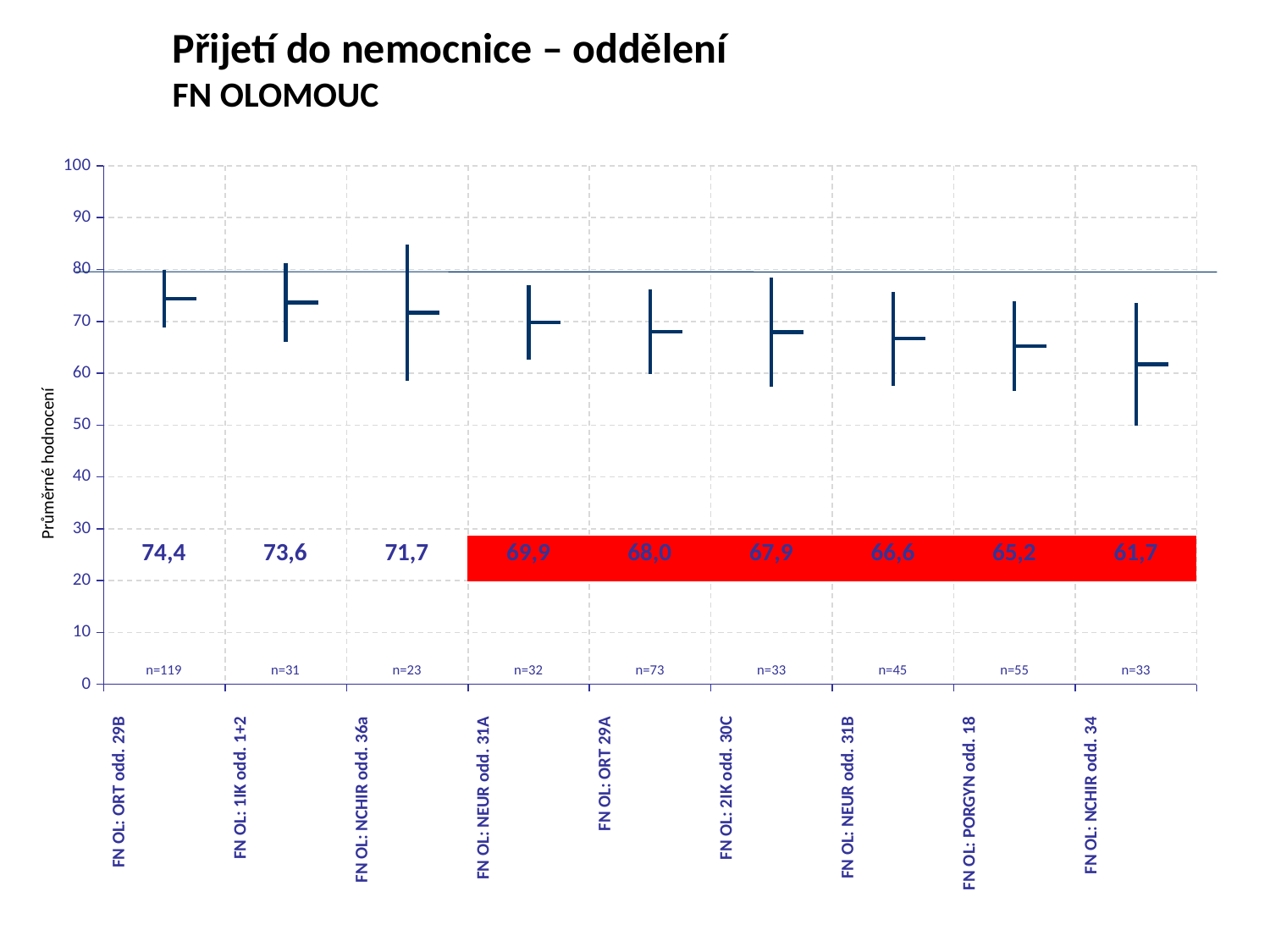
Which department has the highest average rating? FN OL: ORT odd. 29B How many departments are shown on the chart? 9 What is the average rating for FN OL: PORGYN odd. 18? 65,2 Which department has the lowest average rating? FN OL: NCHIR odd. 34 What is the average rating for FN OL: NCHIR odd. 34? 61,7 What is the difference between the average ratings of FN OL: ORT odd. 29B and FN OL: NCHIR odd. 34? 12,7 How many departments have their value highlighted with a red band? 6 What is the average rating for FN OL: ORT odd. 29B? 74,4 What is the label of the vertical axis? Průměrné hodnocení What is the sample size (n) for FN OL: ORT odd. 29B? n=119 Do the average ratings rise or fall from left to right along the x axis? fall Which has a higher average rating, FN OL: 1IK odd. 1+2 or FN OL: NEUR odd. 31B? FN OL: 1IK odd. 1+2